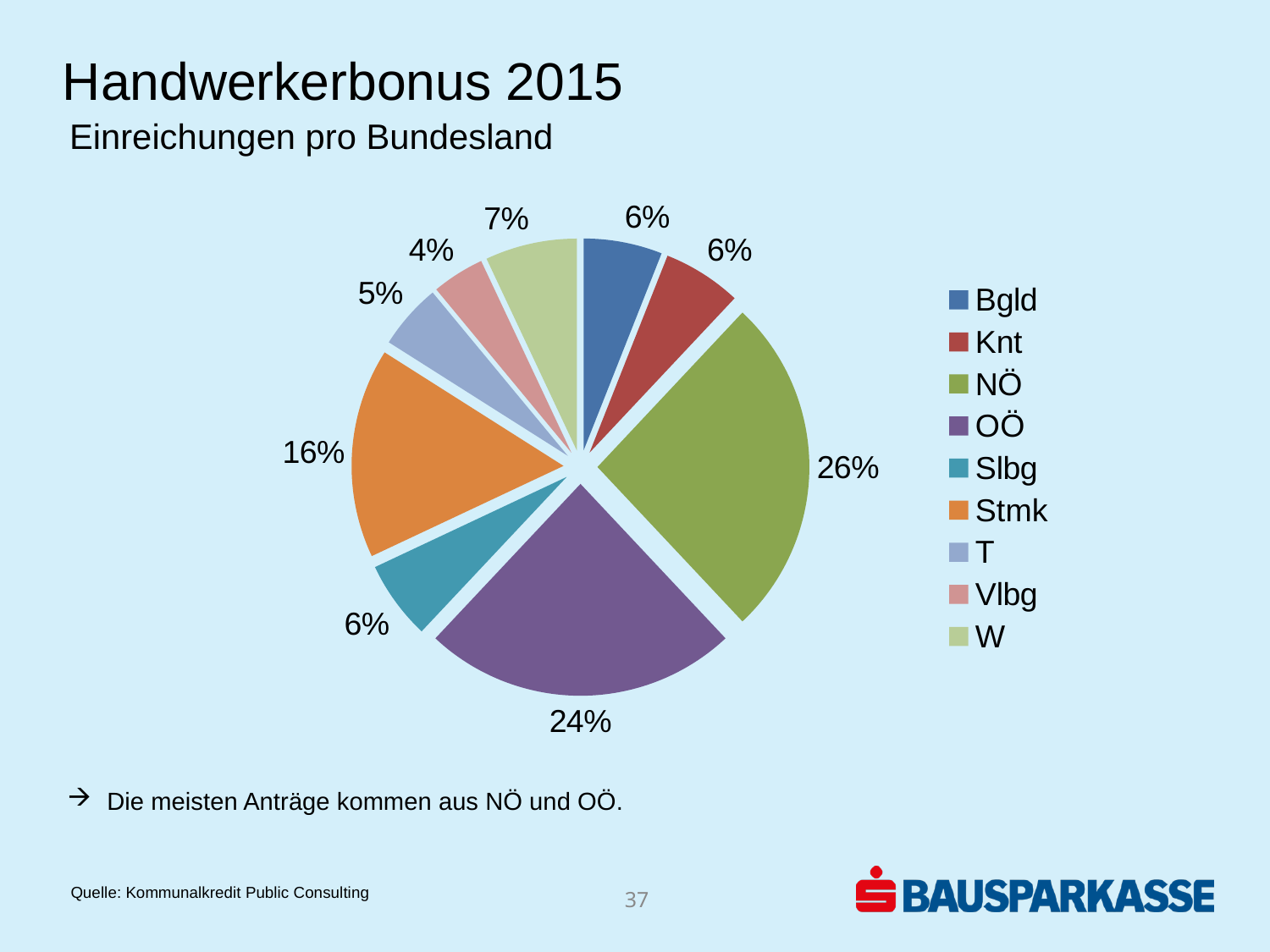
How many Bundesländer (slices) are shown in the pie chart? 9 Which Bundesland has the smallest share of the pie? Vlbg What share of the pie does NÖ have? 26% What is the value shown for Stmk? 16% What is the value shown for W? 7% What is the subtitle of the chart below 'Handwerkerbonus 2015'? Einreichungen pro Bundesland Which has a larger share, Stmk or W? Stmk What is the difference in percentage points between Stmk and T? 11 What is the value shown for OÖ? 24% Which Bundesland has the largest share of the pie? NÖ What is the difference in percentage points between NÖ and OÖ? 2 What type of chart is shown on the slide? pie chart